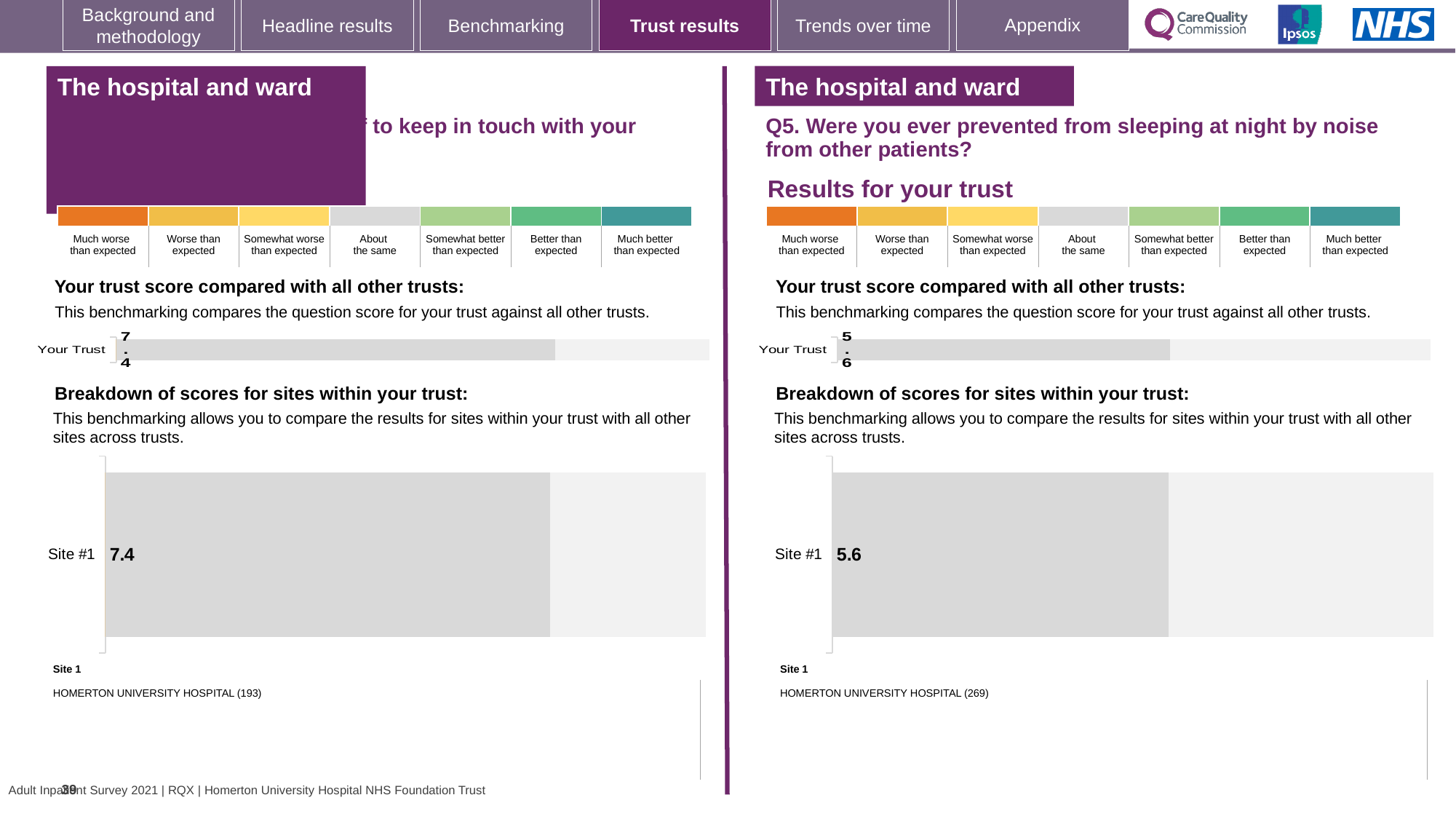
On the left-hand panel, how many respondents are shown in brackets next to HOMERTON UNIVERSITY HOSPITAL for Site 1? 193 On the right-hand panel (Q5), which hospital is listed as Site 1? HOMERTON UNIVERSITY HOSPITAL (269) On the right-hand chart (Q5), what is the score shown for Site #1? 5.6 On the left-hand chart, what is the score shown for Site #1? 7.4 What is the difference between the Site #1 score on the left-hand chart and the Site #1 score on the right-hand chart (Q5)? 1.8 How many sites are shown in the breakdown of scores on the right-hand chart (Q5)? 1 On the right-hand chart (Q5, noise from other patients), what is the score shown for Your Trust? 5.6 How many sites are shown in the breakdown of scores on the left-hand chart? 1 On the left-hand chart, what is the score shown for Your Trust? 7.4 Which is larger: the Your Trust score on the left-hand chart or the Your Trust score on the right-hand chart (Q5)? Left-hand chart What kind of chart is used to show the Site #1 score on the right-hand panel (Q5)? Bar chart